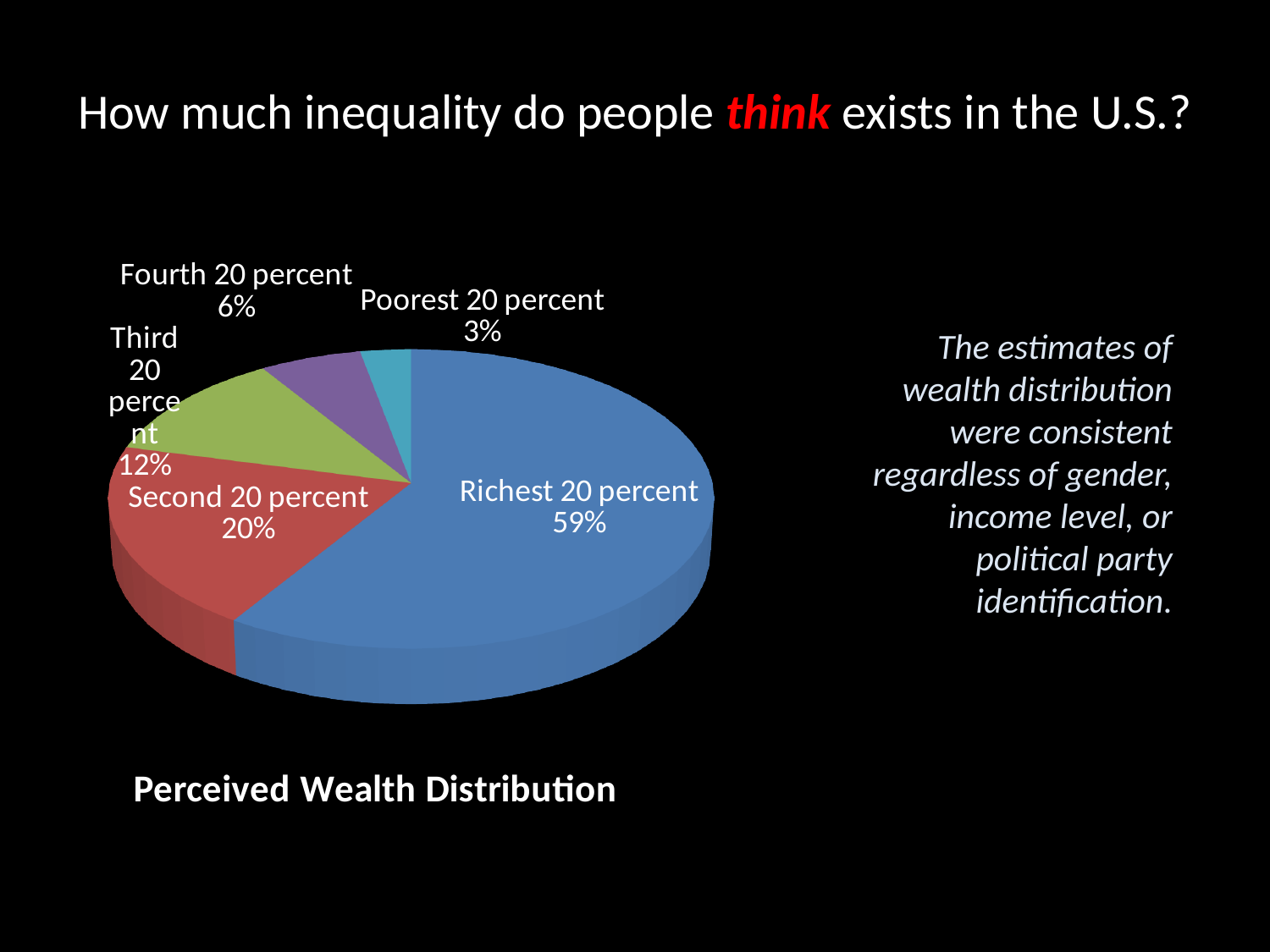
What share of perceived wealth is held by the Fourth 20 percent? 6% What share of perceived wealth is held by the Richest 20 percent? 59% Which group has the smallest slice of the pie? Poorest 20 percent How many slices does the pie chart have? 5 What kind of chart is shown on the slide? Pie chart What is the title printed below the pie chart? Perceived Wealth Distribution What is the difference in percentage points between the Richest 20 percent and the Second 20 percent? 39 Which is larger, the share for the Third 20 percent or the Fourth 20 percent? Third 20 percent Which group has the largest slice of the pie? Richest 20 percent What share of perceived wealth is held by the Poorest 20 percent? 3% What share of perceived wealth is held by the Second 20 percent? 20% What share of perceived wealth is held by the Third 20 percent? 12%